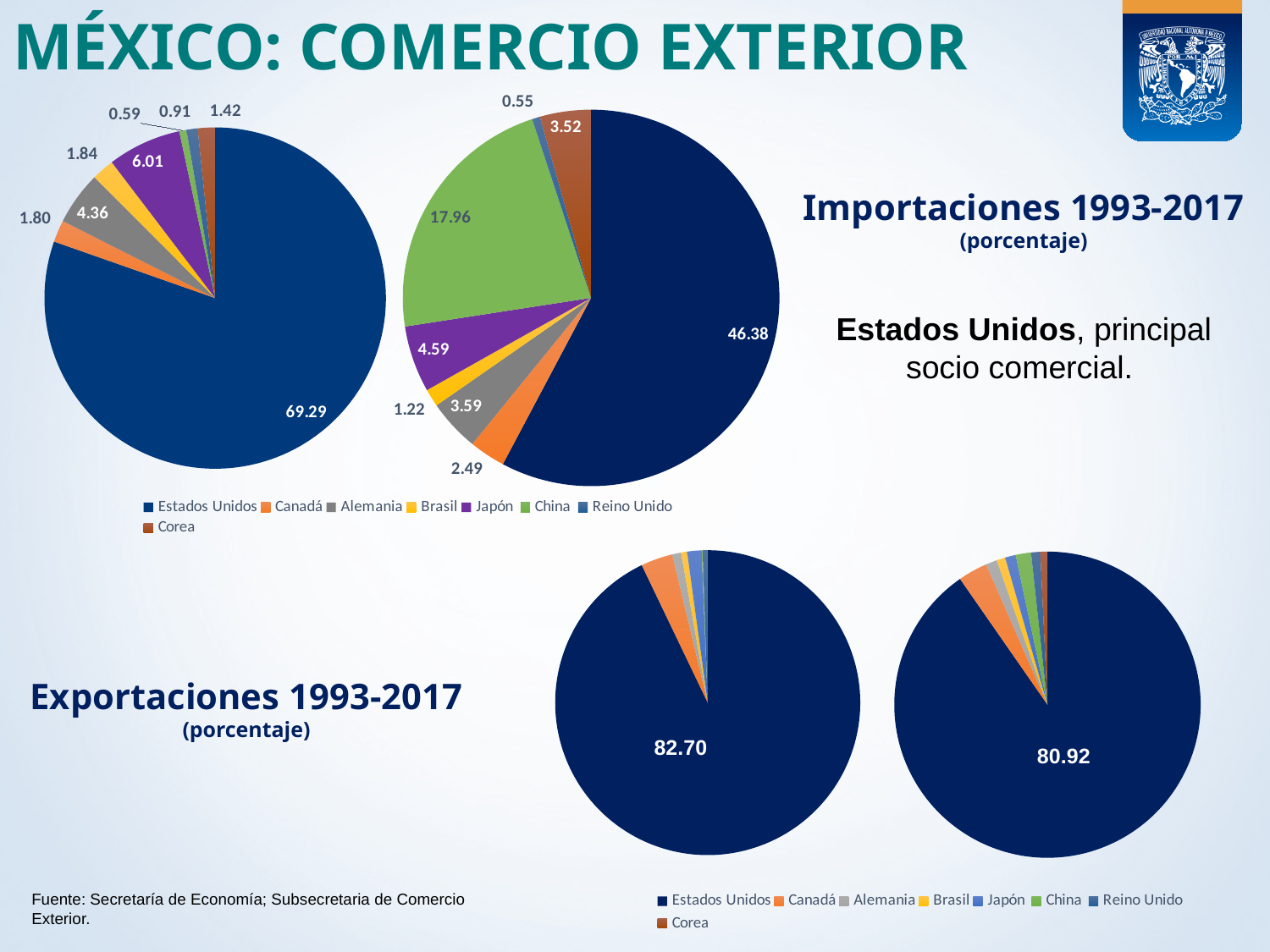
In the top-middle pie chart (Importaciones), what is the value for China? 17.96 In the top-middle pie chart (Importaciones), what is the difference between the values for Estados Unidos and China? 28.42 In the top-middle pie chart (Importaciones), what is the value for Corea? 3.52 In the top-left pie chart (Importaciones), what is the value for Japón? 6.01 How many categories does the legend list for the Importaciones pie charts? 8 In the top-middle pie chart (Importaciones), which category has the largest slice? Estados Unidos In the top-left pie chart (Importaciones), which is larger, the value for Alemania or the value for Japón? Japón In the bottom-right pie chart (Exportaciones), what is the value for Estados Unidos? 80.92 In the top-middle pie chart (Importaciones), what is the value for Estados Unidos? 46.38 In the top-middle pie chart (Importaciones), which category has the smallest slice? Reino Unido In the bottom-left pie chart (Exportaciones), what is the value for Estados Unidos? 82.70 In the top-left pie chart (Importaciones), what is the value for Estados Unidos? 69.29